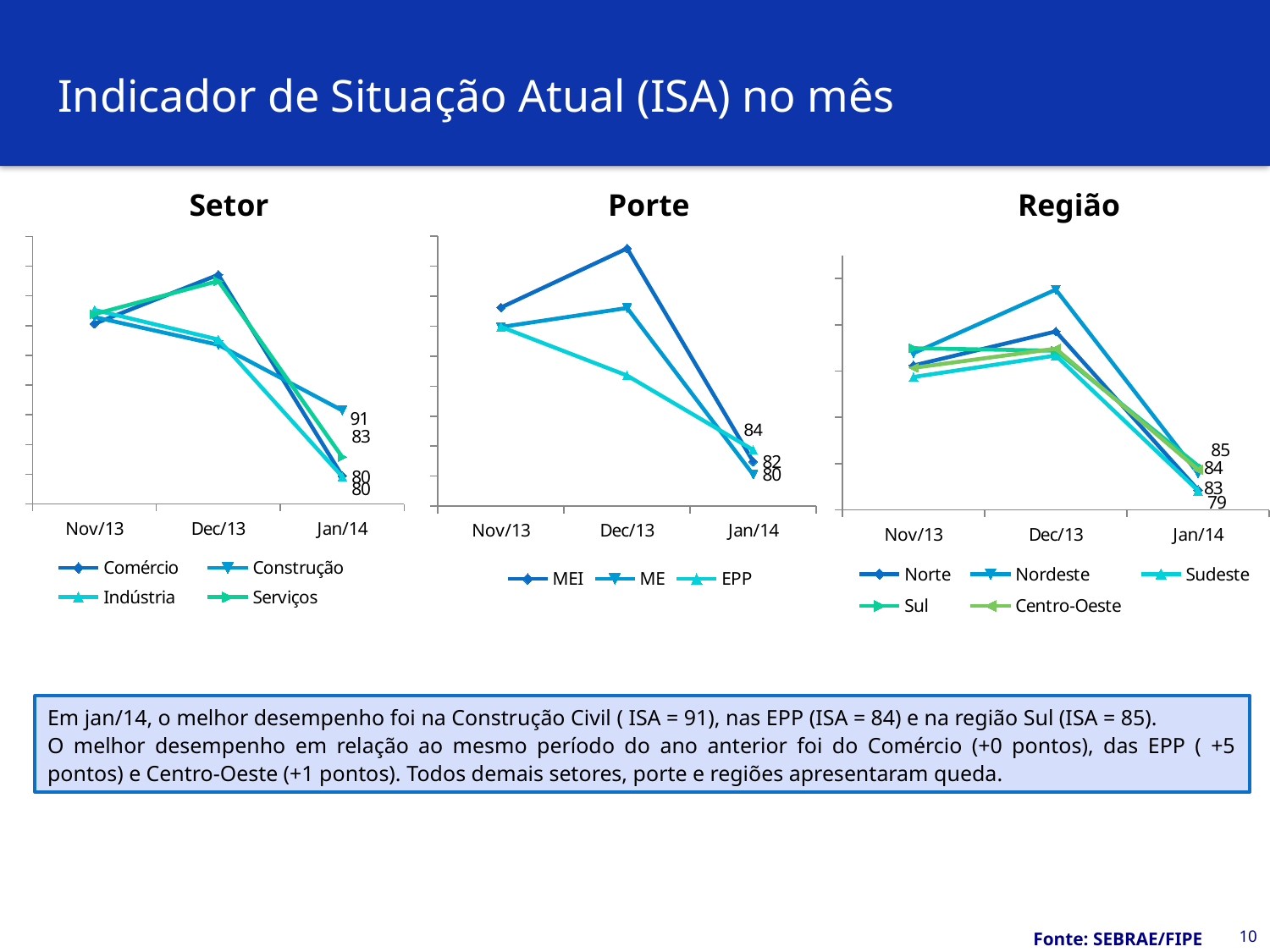
How many series does the legend of the Região chart list? 5 How many time points are shown on the x axis of the Porte chart? 3 In the Setor chart, which series has the highest value in Jan/14? Construção How many series does the legend of the Setor chart list? 4 In the Porte chart, what is the value for EPP in Jan/14? 84 In the Região chart, what is the value for Sul in Jan/14? 85 In the Porte chart, which series has the lowest value in Jan/14? ME In the Região chart, which region has the highest value in Jan/14? Sul What kind of chart is the Porte chart? Line chart In the Setor chart, what is the value for Construção in Jan/14? 91 In the Porte chart, which is larger in Jan/14, MEI or ME? MEI In the Porte chart, what is the difference between EPP and ME in Jan/14? 4